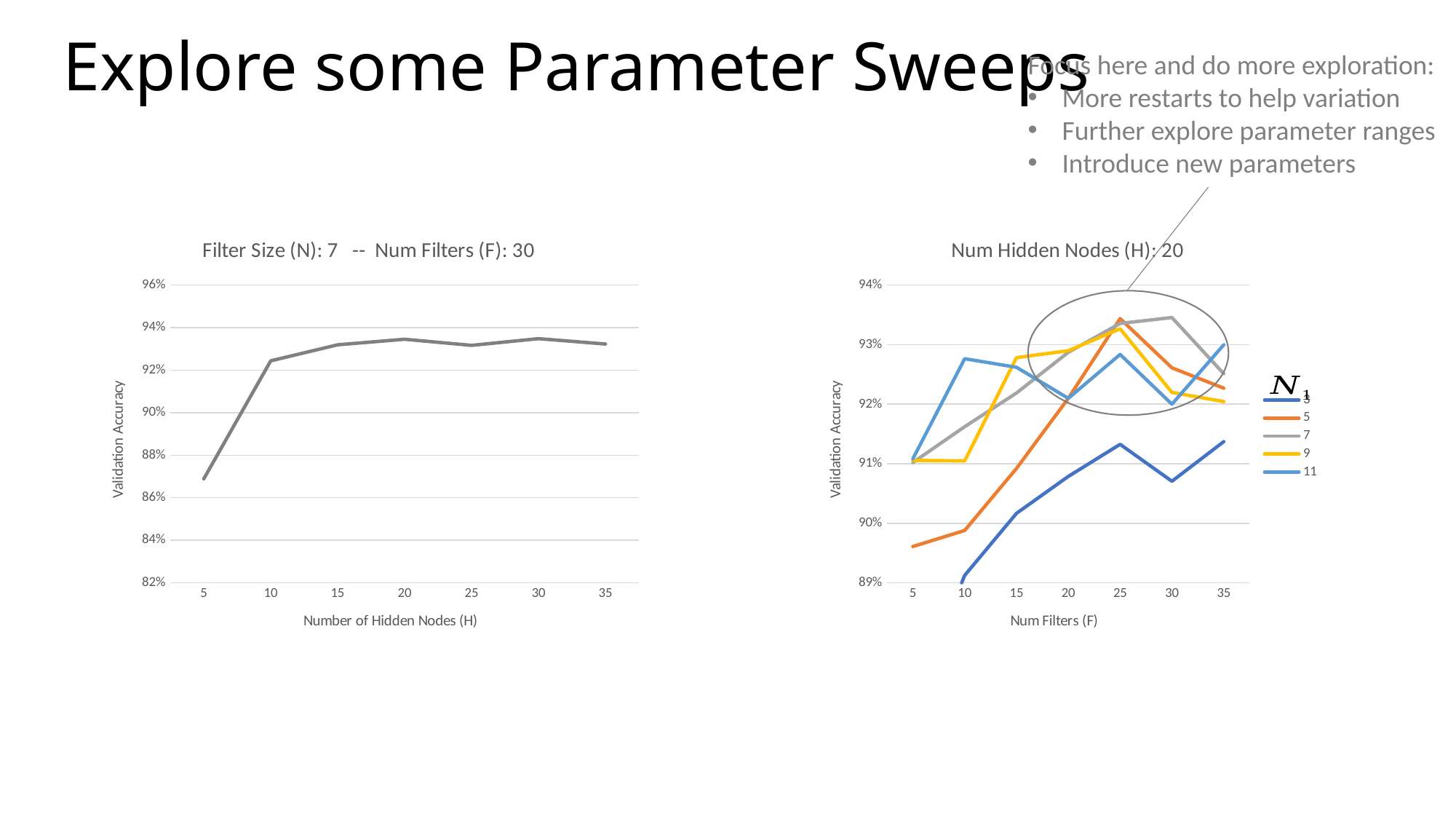
How many series does the legend of the right chart (Num Hidden Nodes (H): 20) list? 5 In the right chart (Num Hidden Nodes (H): 20), is the validation accuracy for series 5 at 5 filters greater or less than 90%? less In the left chart (Filter Size (N): 7 -- Num Filters (F): 30), is the validation accuracy at 5 hidden nodes greater or less than 88%? less In the left chart (Filter Size (N): 7 -- Num Filters (F): 30), at which number of hidden nodes is validation accuracy lowest? 5 In the right chart (Num Hidden Nodes (H): 20), is the validation accuracy for series 11 at 10 filters greater or less than 92%? greater In the left chart (Filter Size (N): 7 -- Num Filters (F): 30), how many data points are plotted along the x axis? 7 In the right chart (Num Hidden Nodes (H): 20), at which number of filters does series 5 reach its highest validation accuracy? 25 In the right chart (Num Hidden Nodes (H): 20), at 35 filters, which series has the higher validation accuracy, 9 or 11? 11 In the left chart (Filter Size (N): 7 -- Num Filters (F): 30), does validation accuracy generally rise or fall as the number of hidden nodes increases from 5 to 35? rise What kind of chart is the left chart titled 'Filter Size (N): 7 -- Num Filters (F): 30'? line chart What is the x-axis title of the right chart (Num Hidden Nodes (H): 20)? Num Filters (F)